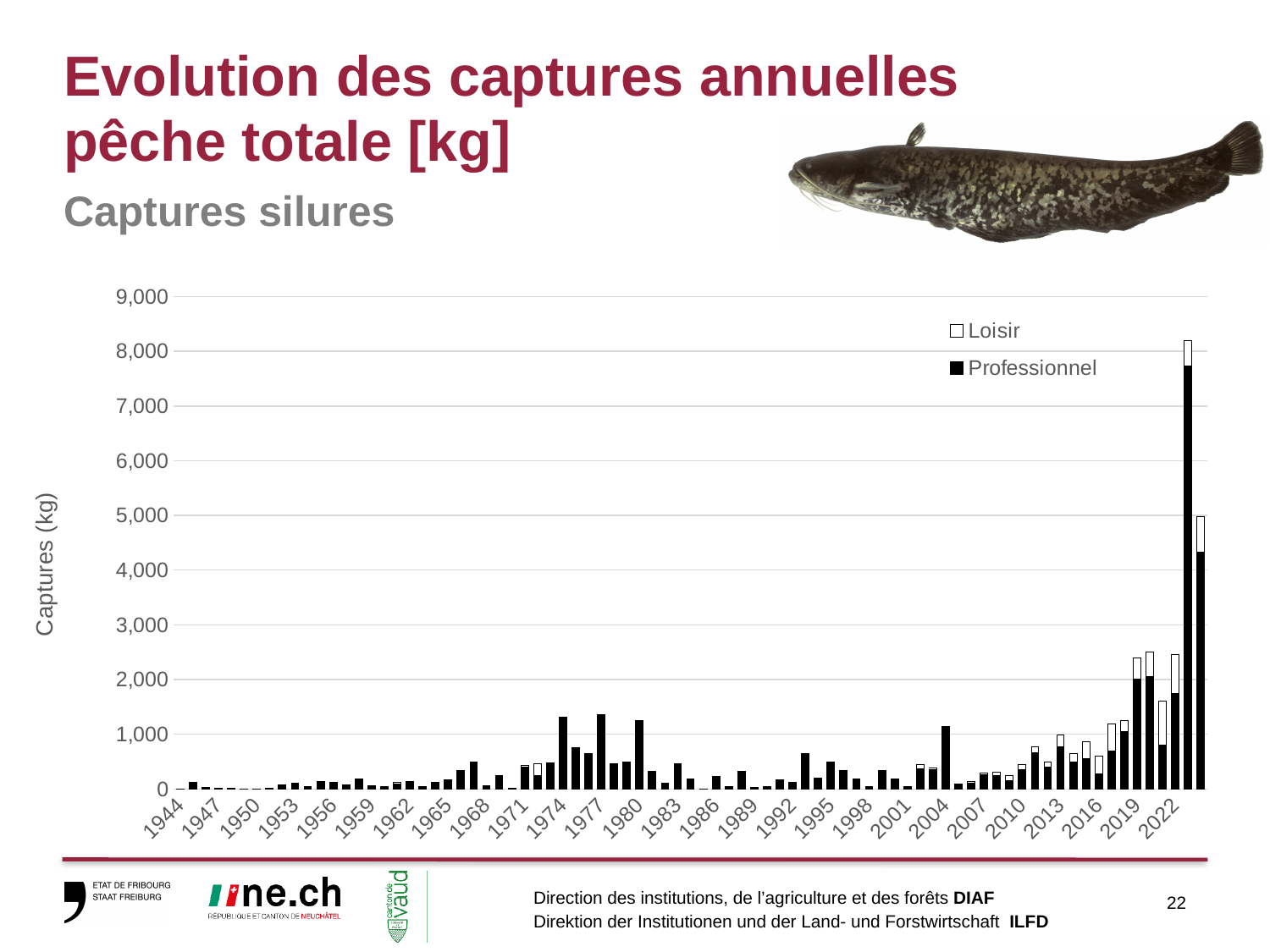
What is the label of the vertical axis? Captures (kg) Which year has the larger total catch, 1950 or 1977? 1977 How many series does the legend list? 2 Overall, do the catches rise or fall from 1944 to 2022? rise What kind of chart is shown on the slide? Stacked bar chart Is the total value for 1944 greater or less than 1,000? less Which year has the larger total catch, 1944 or 2022? 2022 What is the highest value shown on the vertical axis? 9,000 Is the total value for 1974 greater or less than 1,000? greater Is the total value for 2022 greater or less than 1,000? greater What are the two series named in the legend? Loisir and Professionnel